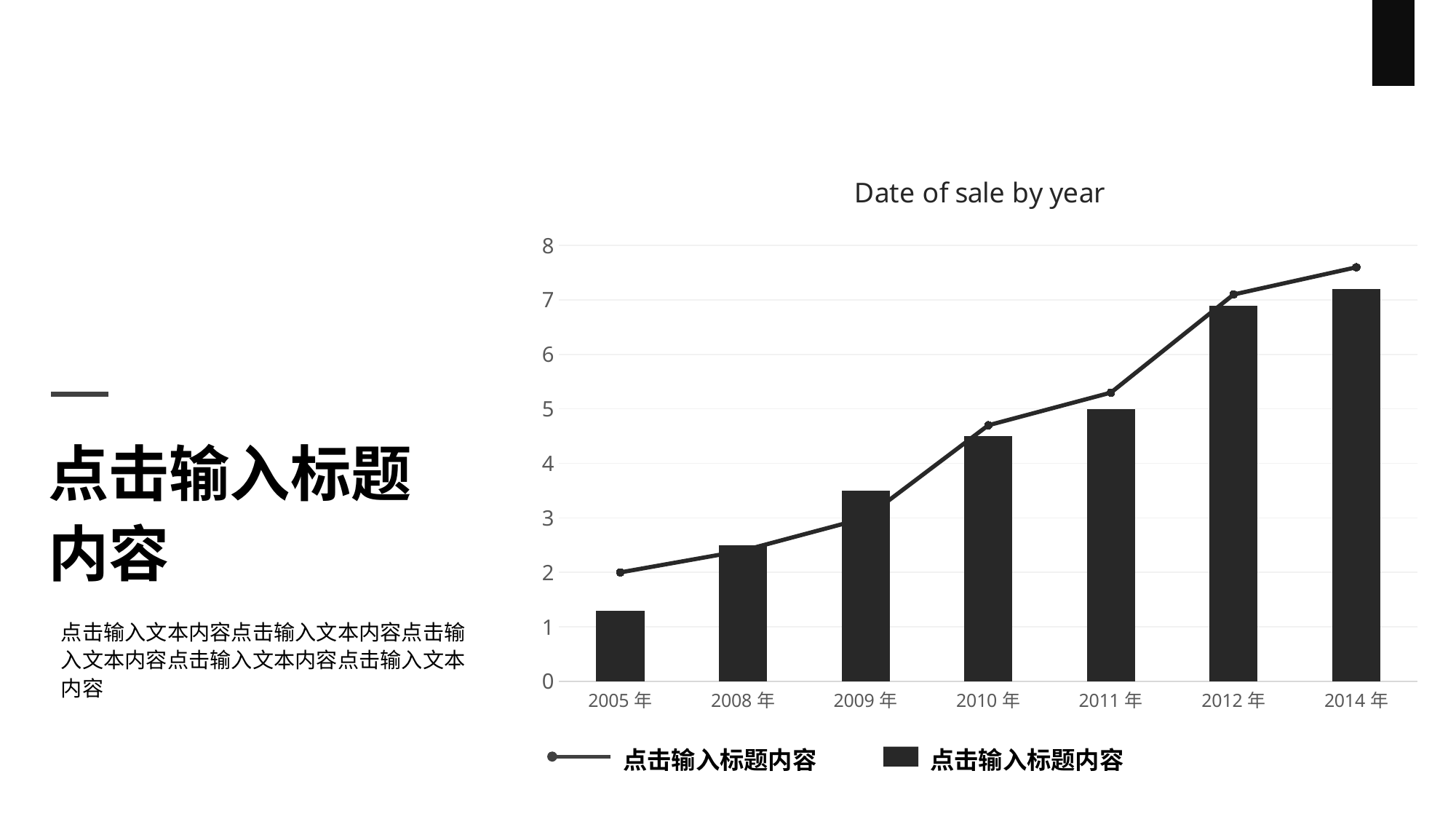
How many year categories are shown on the x axis? 7 Is the bar value for 2012 年 greater or less than 6? greater Which year has the tallest bar? 2014 年 Is the line value for 2014 年 greater or less than 7? greater Do the bar values rise or fall from 2005 年 to 2014 年? Rise What is the title of the chart? Date of sale by year Which has the larger bar value, 2010 年 or 2008 年? 2010 年 What kind of chart is shown on the slide? A combined bar and line chart Is the bar value for 2009 年 greater or less than 3? greater Which year has the shortest bar? 2005 年 How many series does the legend list? 2